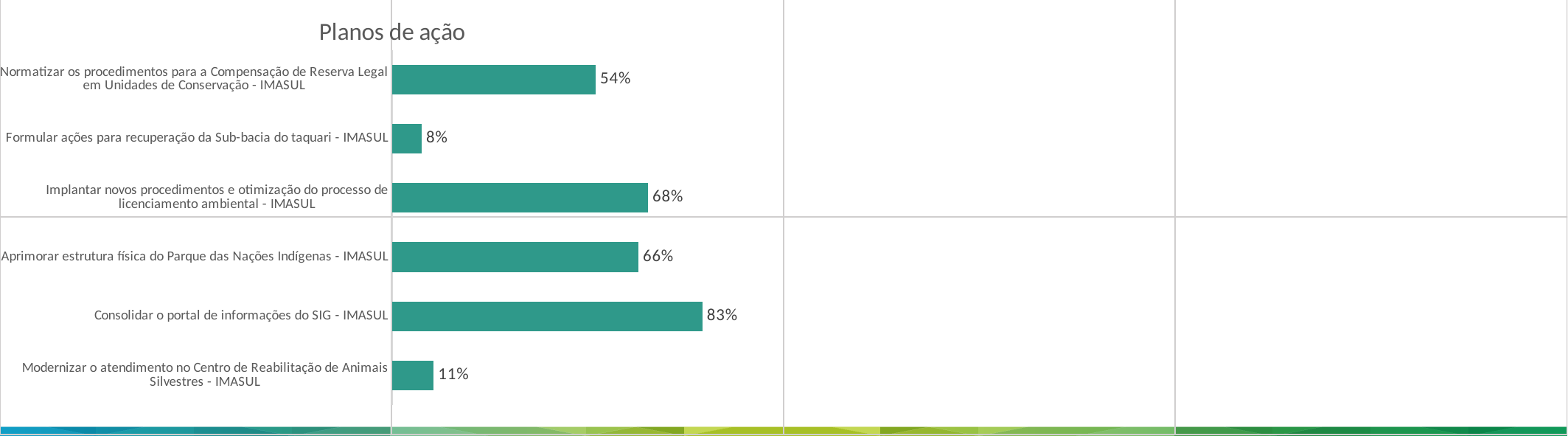
What is the value for 'Consolidar o portal de informações do SIG - IMASUL'? 83% What is the difference between the values for 'Modernizar o atendimento no Centro de Reabilitação de Animais Silvestres - IMASUL' and 'Formular ações para recuperação da Sub-bacia do taquari - IMASUL'? 3% Which is larger: the value for 'Aprimorar estrutura física do Parque das Nações Indígenas - IMASUL' or for 'Normatizar os procedimentos para a Compensação de Reserva Legal em Unidades de Conservação - IMASUL'? Aprimorar estrutura física do Parque das Nações Indígenas - IMASUL What is the difference between the values for 'Consolidar o portal de informações do SIG - IMASUL' and 'Normatizar os procedimentos para a Compensação de Reserva Legal em Unidades de Conservação - IMASUL'? 29% Which action plan has the lowest value? Formular ações para recuperação da Sub-bacia do taquari - IMASUL What is the value for 'Implantar novos procedimentos e otimização do processo de licenciamento ambiental - IMASUL'? 68% Which action plan has the highest value? Consolidar o portal de informações do SIG - IMASUL How many action plans are shown in the chart? 6 What is the title of the chart? Planos de ação What kind of chart is shown on the slide? Bar chart What is the value for 'Modernizar o atendimento no Centro de Reabilitação de Animais Silvestres - IMASUL'? 11% What is the value for 'Formular ações para recuperação da Sub-bacia do taquari - IMASUL'? 8%